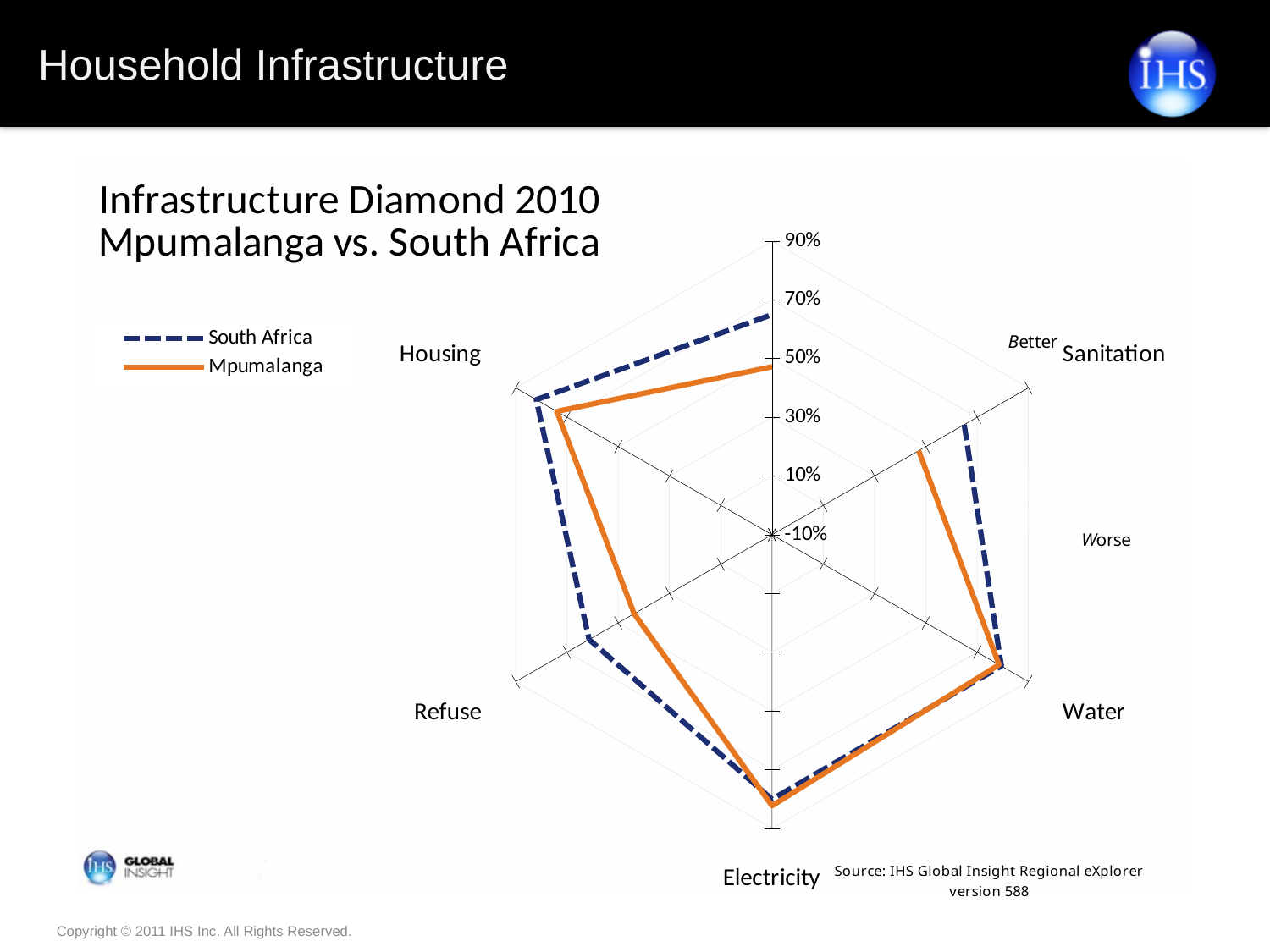
Is the South Africa value for Refuse greater or less than 50%? greater How many series does the legend list? 2 Is the Mpumalanga value for Water greater or less than 70%? greater What is the title of the chart? Infrastructure Diamond 2010 Mpumalanga vs. South Africa For Refuse, which series has the higher value, South Africa or Mpumalanga? South Africa Is the Mpumalanga value for Sanitation greater or less than 30%? greater For Housing, which series has the higher value, South Africa or Mpumalanga? South Africa For Sanitation, which series has the higher value, South Africa or Mpumalanga? South Africa What kind of chart is shown on the slide? Radar chart Which series is drawn with a dashed line? South Africa